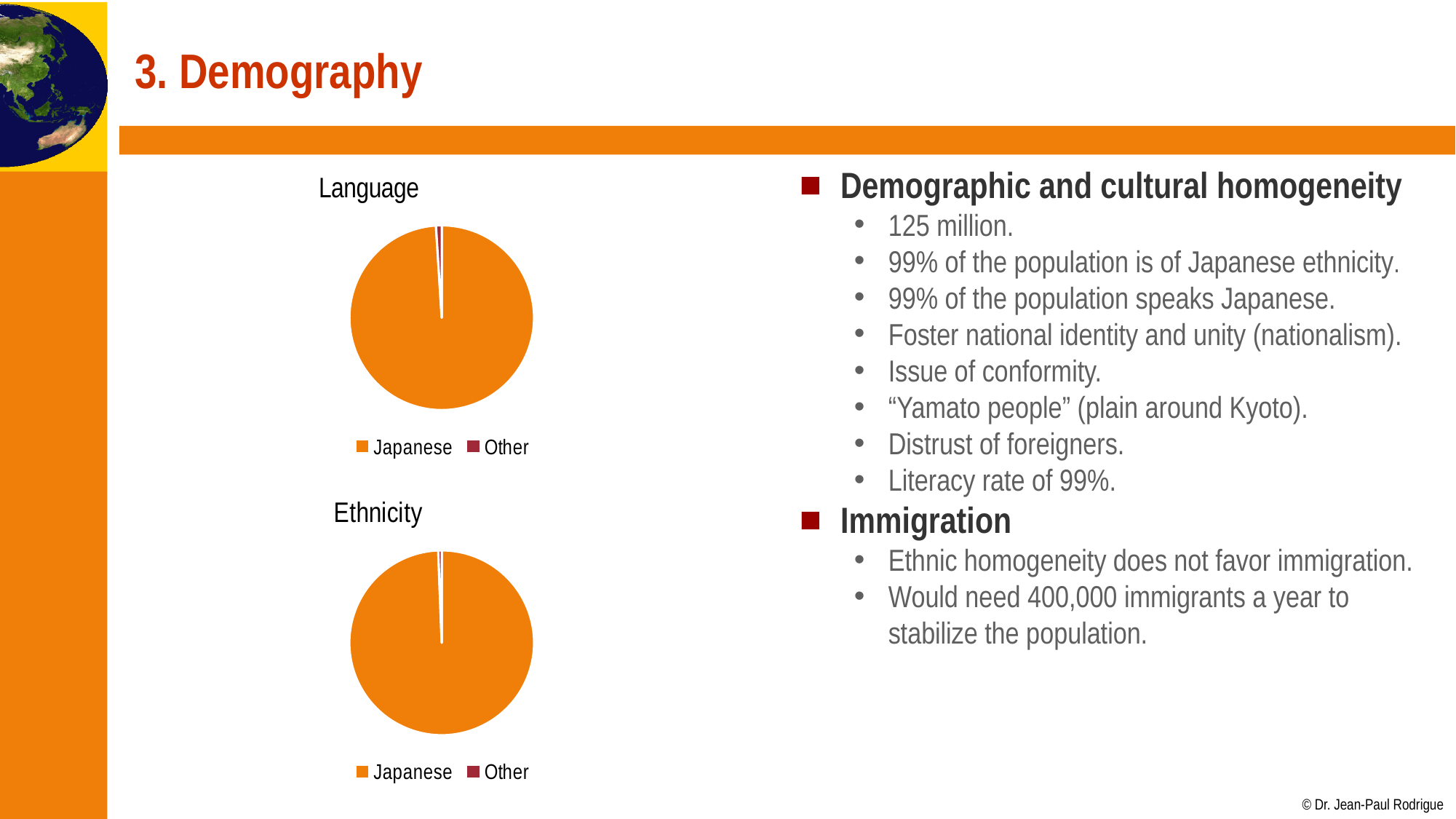
In the "Ethnicity" chart, which slice is larger, Japanese or Other? Japanese In the "Ethnicity" chart, what colour represents the Japanese category? orange In the "Ethnicity" chart, which category has the largest slice? Japanese How many categories does the "Language" pie chart have? 2 In the "Language" chart, which slice is larger, Japanese or Other? Japanese In the "Ethnicity" chart, which category has the smallest slice? Other What is the title of the upper pie chart on the slide? Language In the "Language" chart, which category has the largest slice? Japanese In the "Language" chart, which category has the smallest slice? Other How many entries does the legend of the "Ethnicity" chart list? 2 What kind of chart is the "Language" chart? pie chart What kind of chart is the "Ethnicity" chart? pie chart